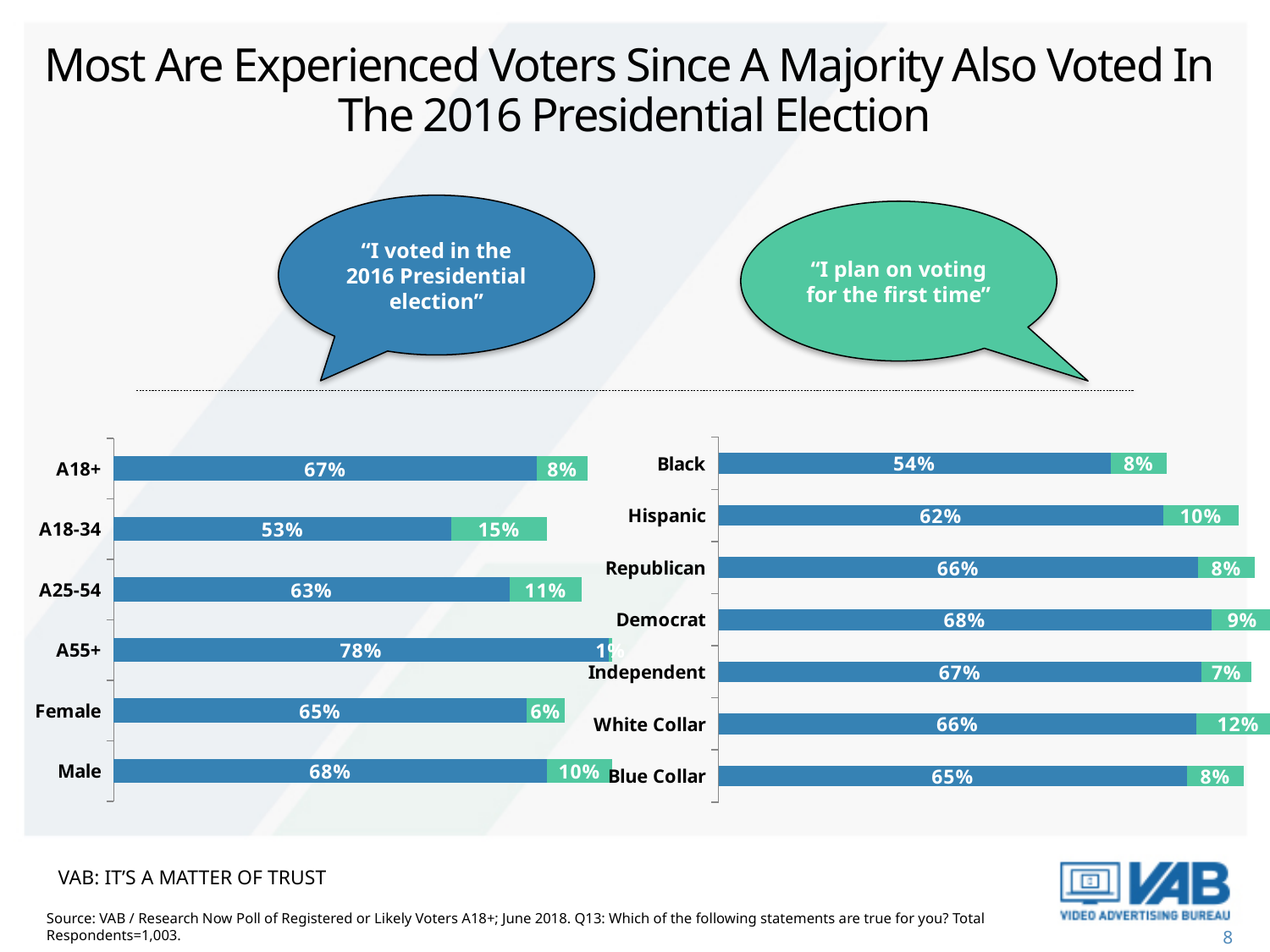
How many categories are shown on the right chart? 7 What does the green series on the charts represent? "I plan on voting for the first time" On the left chart, what is the difference between the Male and Female percentages who voted in the 2016 Presidential election? 3% On the right chart, which is larger: the share of Republicans or the share of Black respondents who voted in the 2016 Presidential election? Republican On the left chart, which category has the highest share who voted in the 2016 Presidential election? A55+ On the right chart, which category has the lowest share who voted in the 2016 Presidential election? Black On the left chart, what percentage of A55+ said "I voted in the 2016 Presidential election"? 78% On the right chart, which category has the highest share who plan on voting for the first time? White Collar What type of chart is used on the left side of the slide? Bar chart On the right chart, what percentage of Hispanic respondents said "I plan on voting for the first time"? 10% On the right chart, what percentage of Democrats said "I voted in the 2016 Presidential election"? 68% On the left chart, what percentage of A18-34 said "I plan on voting for the first time"? 15%